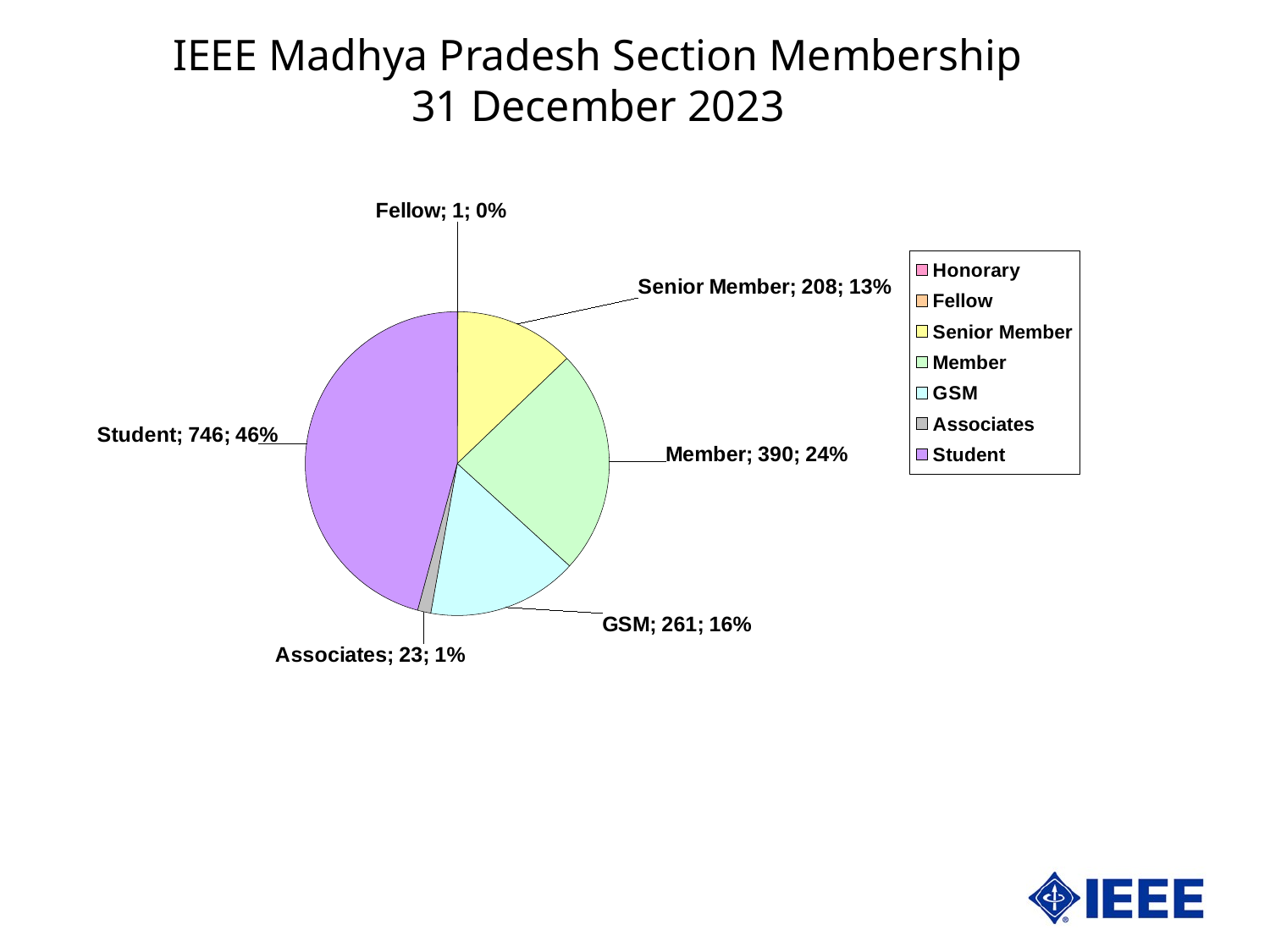
Which category has the largest slice of the pie? Student Which is larger, the GSM count or the Senior Member count? GSM What is the difference between the Member count and the Senior Member count? 182 How many members are in the GSM category? 261 What kind of chart is shown on the slide? Pie chart How many entries does the legend list? 7 How many members are in the Associates category? 23 Which category has the smallest value shown on the chart? Fellow What percentage of membership is Senior Member? 13% What share of the pie does the Member category represent? 24% How many members are in the Student category? 746 What is the title of the chart? IEEE Madhya Pradesh Section Membership 31 December 2023